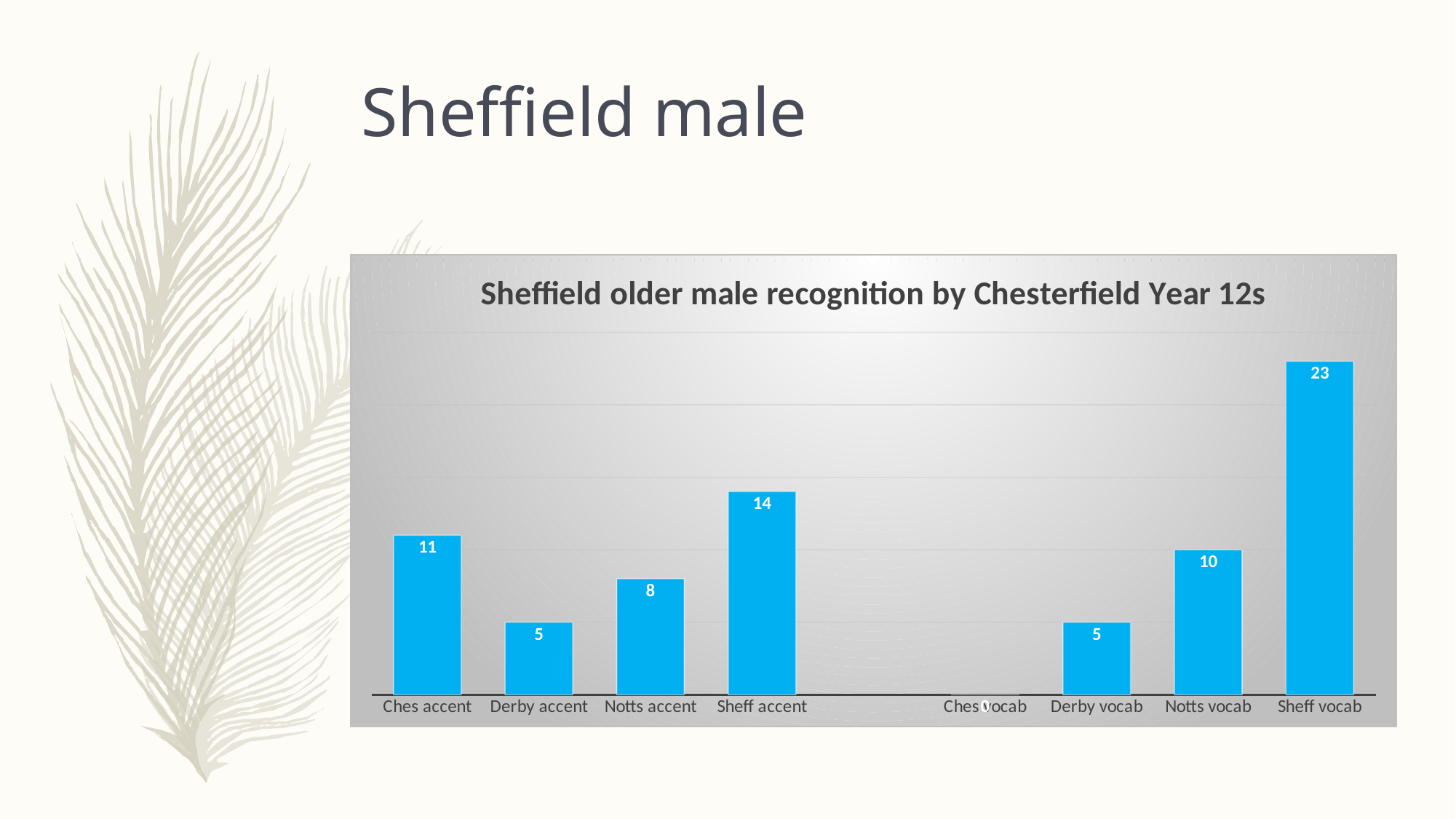
What is the difference between the values for Ches accent and Derby accent? 6 What is the value for Notts vocab? 10 What is the title of the chart? Sheffield older male recognition by Chesterfield Year 12s What is the value for Sheff vocab? 23 What is the value for Ches vocab? 0 What is the value for Notts accent? 8 What is the value for Ches accent? 11 What is the difference between the values for Sheff vocab and Sheff accent? 9 Which category has the lowest value? Ches vocab Which category has the highest value? Sheff vocab Which is larger, the value for Notts vocab or the value for Notts accent? Notts vocab What kind of chart is shown on the slide? Bar chart